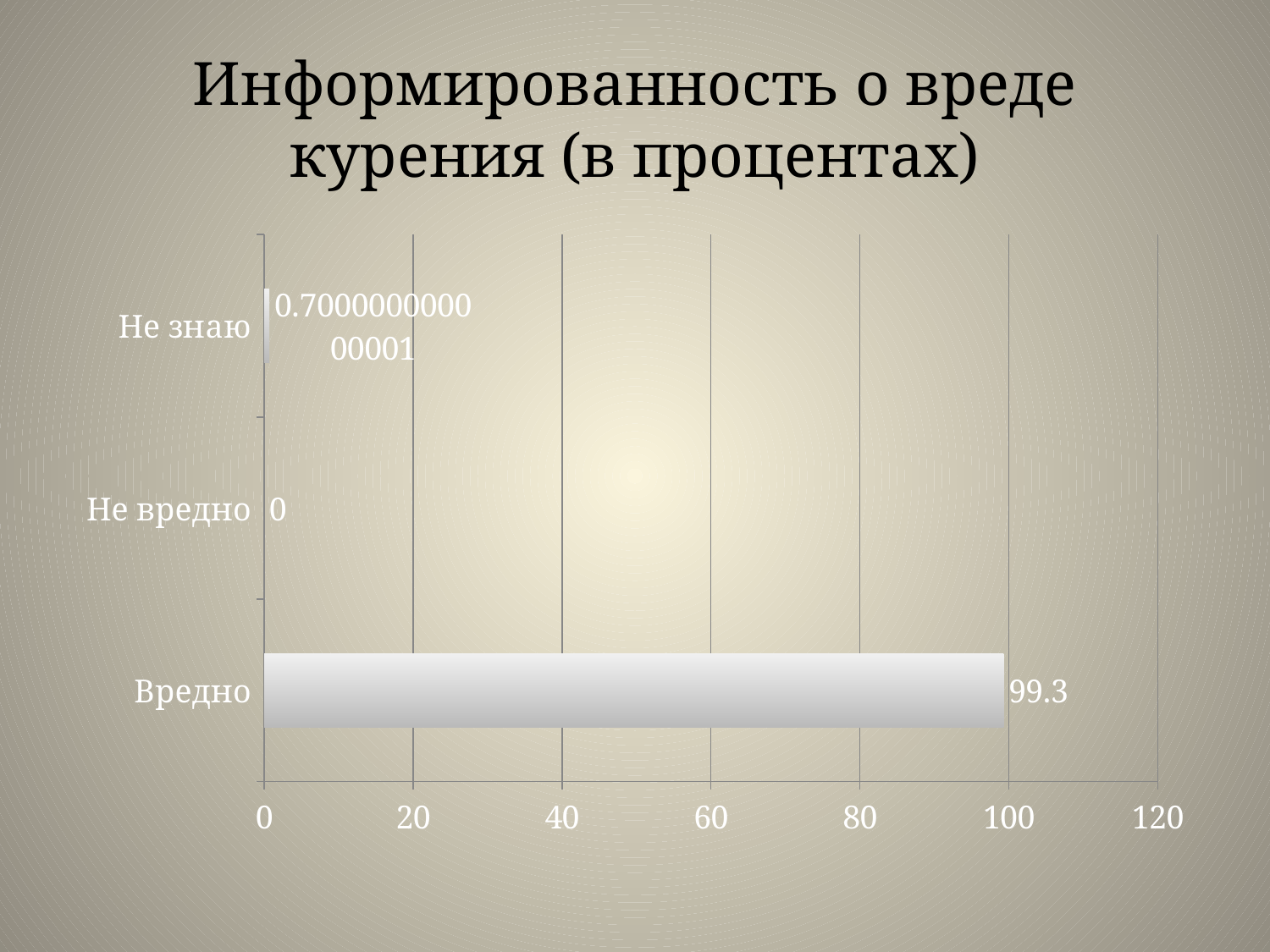
Is the value for Вредно greater or less than 80? greater How many categories are shown in the chart? 3 Which category has the highest value? Вредно What kind of chart is shown on the slide? bar chart What is the title of the chart? Информированность о вреде курения (в процентах) What value is printed next to the bar for Не знаю? 0.700000000000001 What is the value for Вредно? 99.3 What is the value for Не вредно? 0 Which category has the lowest value? Не вредно What is the highest tick value shown on the horizontal axis? 120 Which is larger, the value for Вредно or the value for Не знаю? Вредно What is the difference between the values for Вредно and Не вредно? 99.3